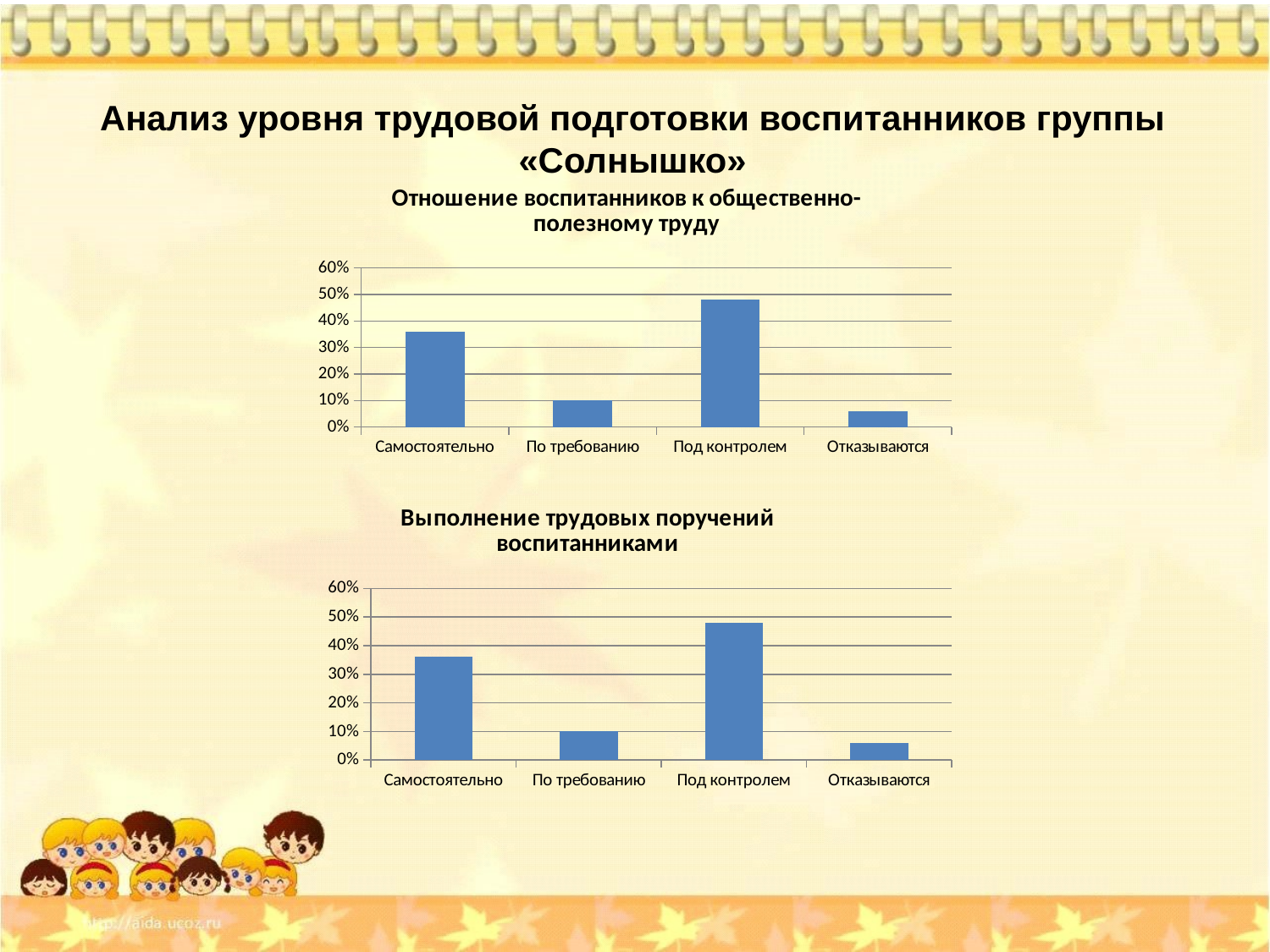
In the top chart 'Отношение воспитанников к общественно-полезному труду', what is the value for По требованию? 10% In the top chart 'Отношение воспитанников к общественно-полезному труду', how many categories are shown on the x axis? 4 In the bottom chart 'Выполнение трудовых поручений воспитанниками', is the value for Отказываются greater or less than 10%? less In the bottom chart 'Выполнение трудовых поручений воспитанниками', what is the value for По требованию? 10% In the top chart 'Отношение воспитанников к общественно-полезному труду', is the value for Под контролем greater or less than 50%? less In the top chart 'Отношение воспитанников к общественно-полезному труду', is the value for Самостоятельно greater or less than 30%? greater In the bottom chart 'Выполнение трудовых поручений воспитанниками', which is larger, the value for Самостоятельно or the value for По требованию? Самостоятельно In the top chart 'Отношение воспитанников к общественно-полезному труду', which category has the lowest value? Отказываются In the top chart 'Отношение воспитанников к общественно-полезному труду', which category has the highest value? Под контролем What type of chart is the bottom chart 'Выполнение трудовых поручений воспитанниками'? Bar chart In the bottom chart 'Выполнение трудовых поручений воспитанниками', which category has the highest value? Под контролем In the bottom chart 'Выполнение трудовых поручений воспитанниками', which category has the lowest value? Отказываются